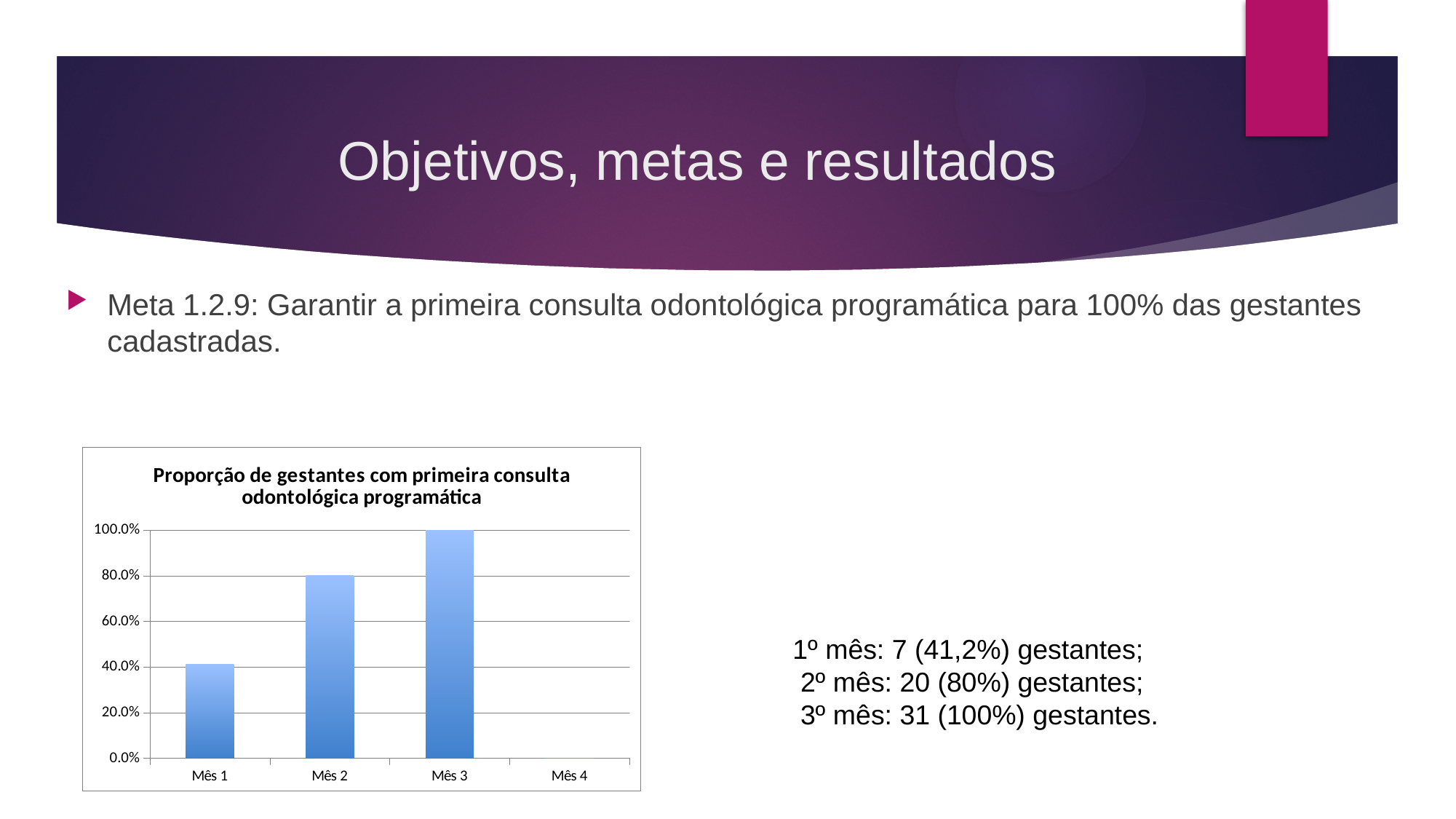
Which month has the highest bar in the chart? Mês 3 What is the value for Mês 2 in the chart? 80.0% What is the value for Mês 3 in the chart? 100.0% Which category on the x axis has no bar plotted? Mês 4 What is the title of the chart? Proporção de gestantes com primeira consulta odontológica programática What is the difference between the values for Mês 3 and Mês 2? 20.0% What kind of chart is shown on the slide? bar chart Which is larger, the value for Mês 1 or the value for Mês 2? Mês 2 How many categories are shown on the x axis of the chart? 4 Is the value for Mês 1 greater or less than 60.0%? less Is the value for Mês 1 greater or less than 20.0%? greater Do the values rise or fall from Mês 1 to Mês 3? rise